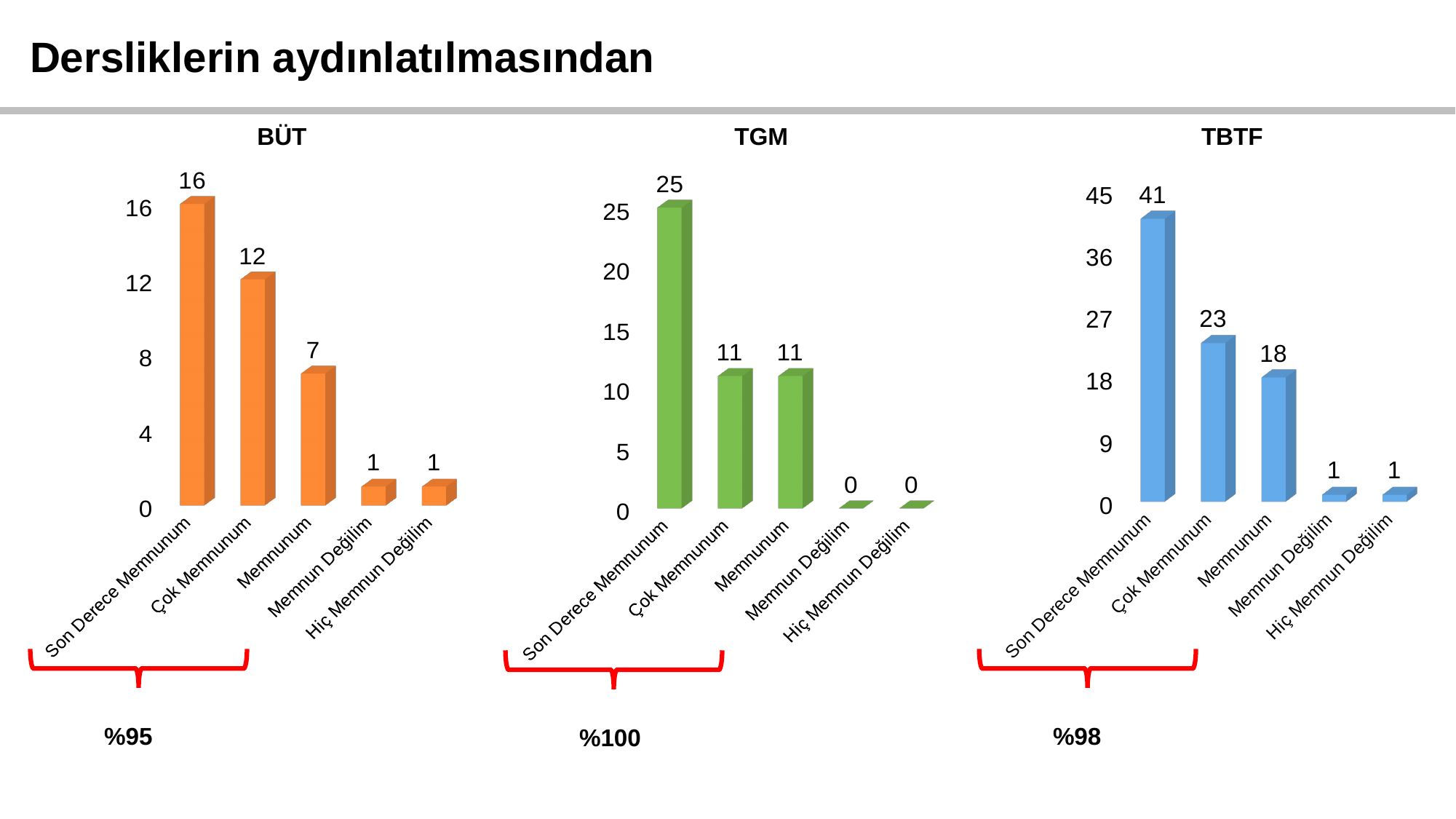
In the BÜT chart, which category has the lowest value among the first three categories (Son Derece Memnunum, Çok Memnunum, Memnunum)? Memnunum In the BÜT chart, what is the value for Son Derece Memnunum? 16 In the TBTF chart, which category has the highest value? Son Derece Memnunum In the TGM chart, what is the difference between Son Derece Memnunum and Çok Memnunum? 14 In the BÜT chart, which is larger, Çok Memnunum or Memnunum? Çok Memnunum In the TBTF chart, what is the value for Memnunum? 18 In the TBTF chart, what is the difference between Son Derece Memnunum and Çok Memnunum? 18 What kind of chart is the TBTF chart? bar chart How many categories does the TGM chart show? 5 In the TGM chart, what is the value for Hiç Memnun Değilim? 0 What percentage is shown below the bracket under the TBTF chart? %98 In the TGM chart, what is the value for Çok Memnunum? 11